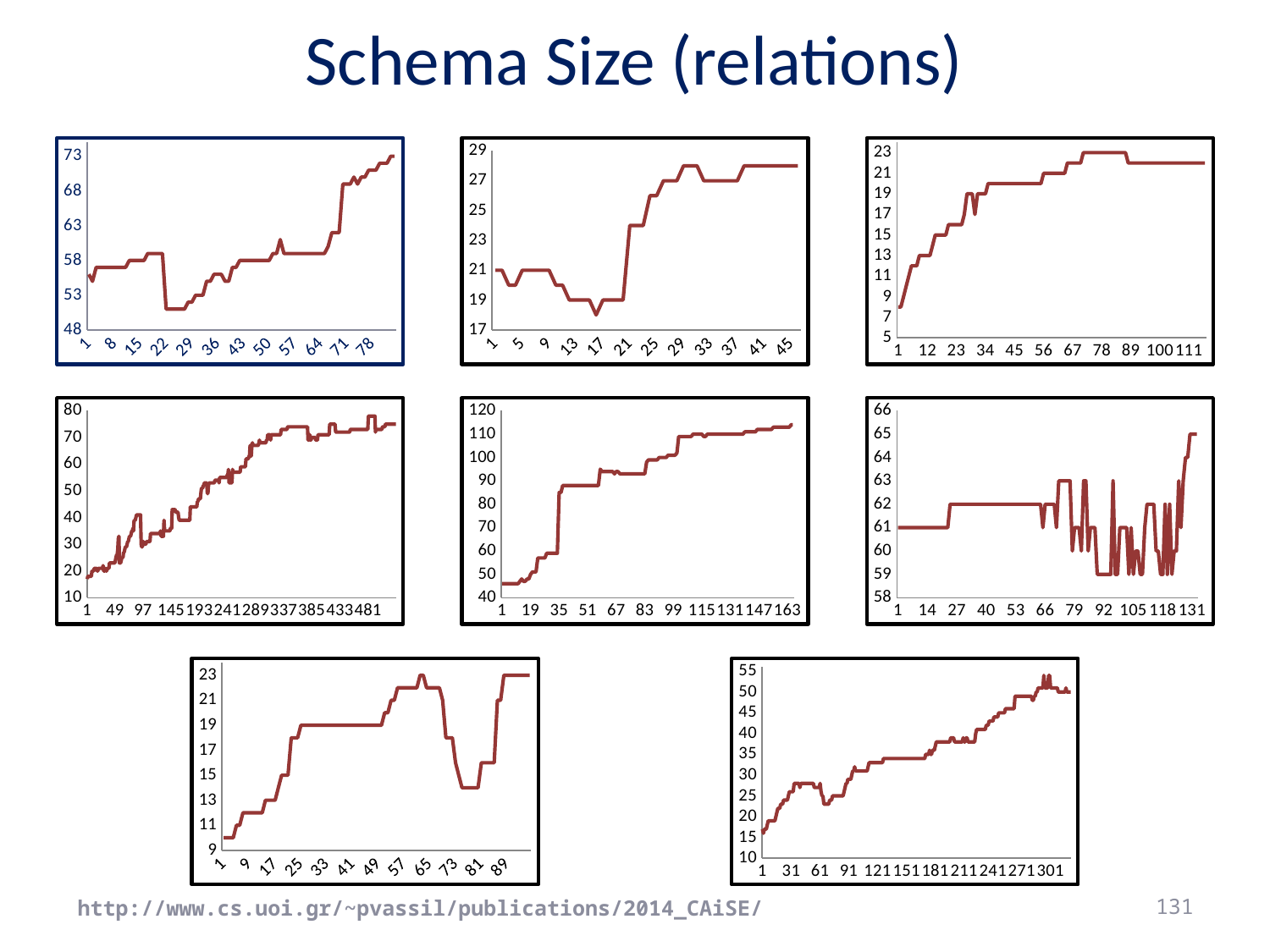
In the bottom-right chart, do the values generally rise or fall along the x axis? rise In the bottom-left chart, is the value at x = 89 greater or less than 21? greater What kind of chart is the top-left chart on the slide? line chart In the middle-row middle chart, is the value at x = 163 greater or less than 100? greater In the middle-row right chart, is the value at x = 1 greater or less than 60? greater What is the title of the slide? Schema Size (relations) How many charts are shown on the slide? 8 In the top-right chart, do the values generally rise or fall along the x axis? rise